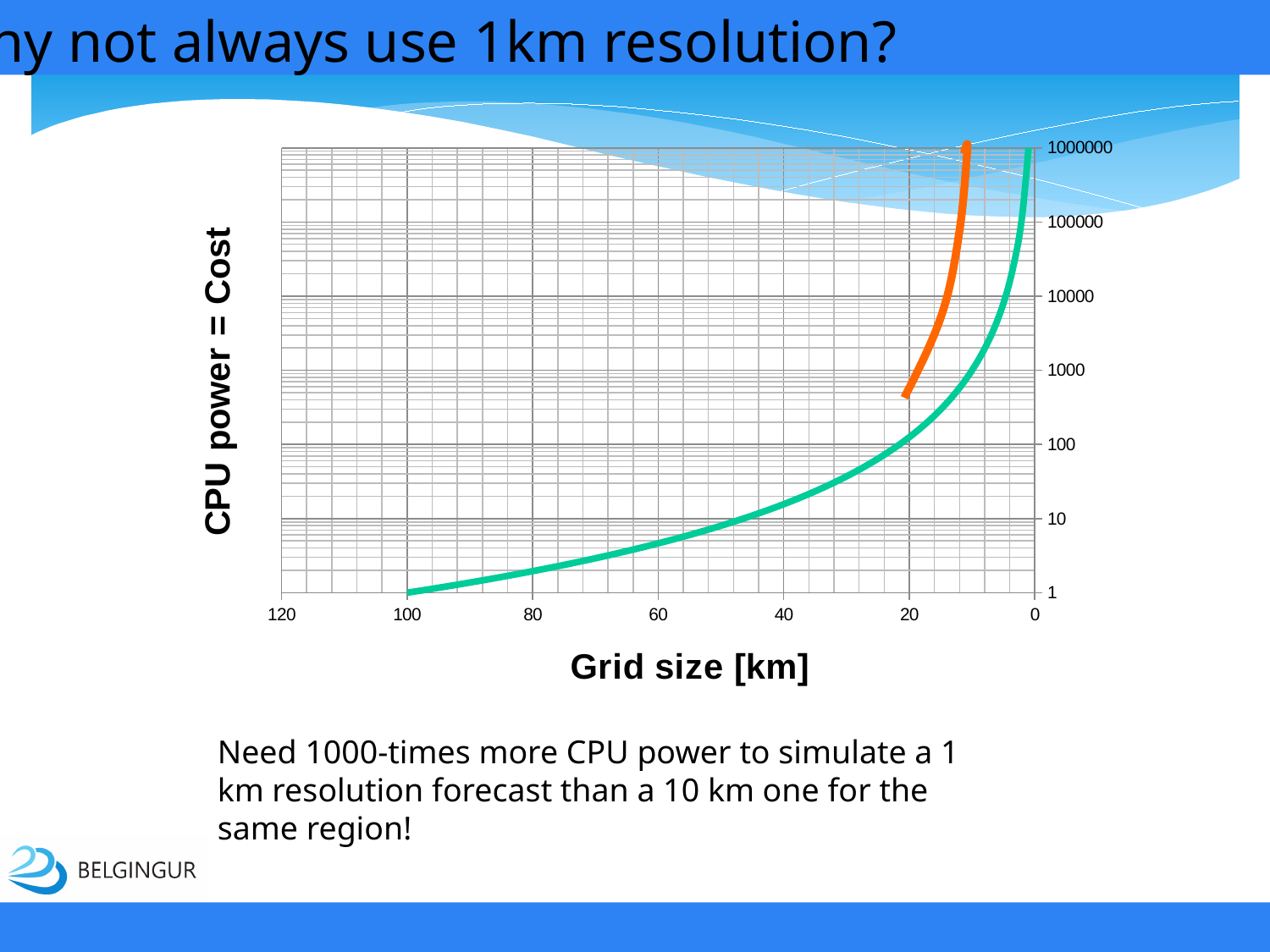
What is the title of the x axis of the chart? Grid size [km] How many lines are plotted on the chart? 2 At a grid size of 15 km, which line has the higher value, the orange line or the green line? orange line Does the green line rise or fall as the grid size decreases from 100 km towards 0 km? rises What is the value of the green line at a grid size of 100 km? 1 Is the value of the green line at a grid size of 60 km greater or less than 10? less Is the value of the green line at a grid size of 40 km greater or less than 10? greater What kind of chart is shown on the slide? line chart What is the highest value labelled on the y axis of the chart? 1000000 Is the value of the orange line at a grid size of 20 km greater or less than 1000? less What is the title of the y axis of the chart? CPU power = Cost